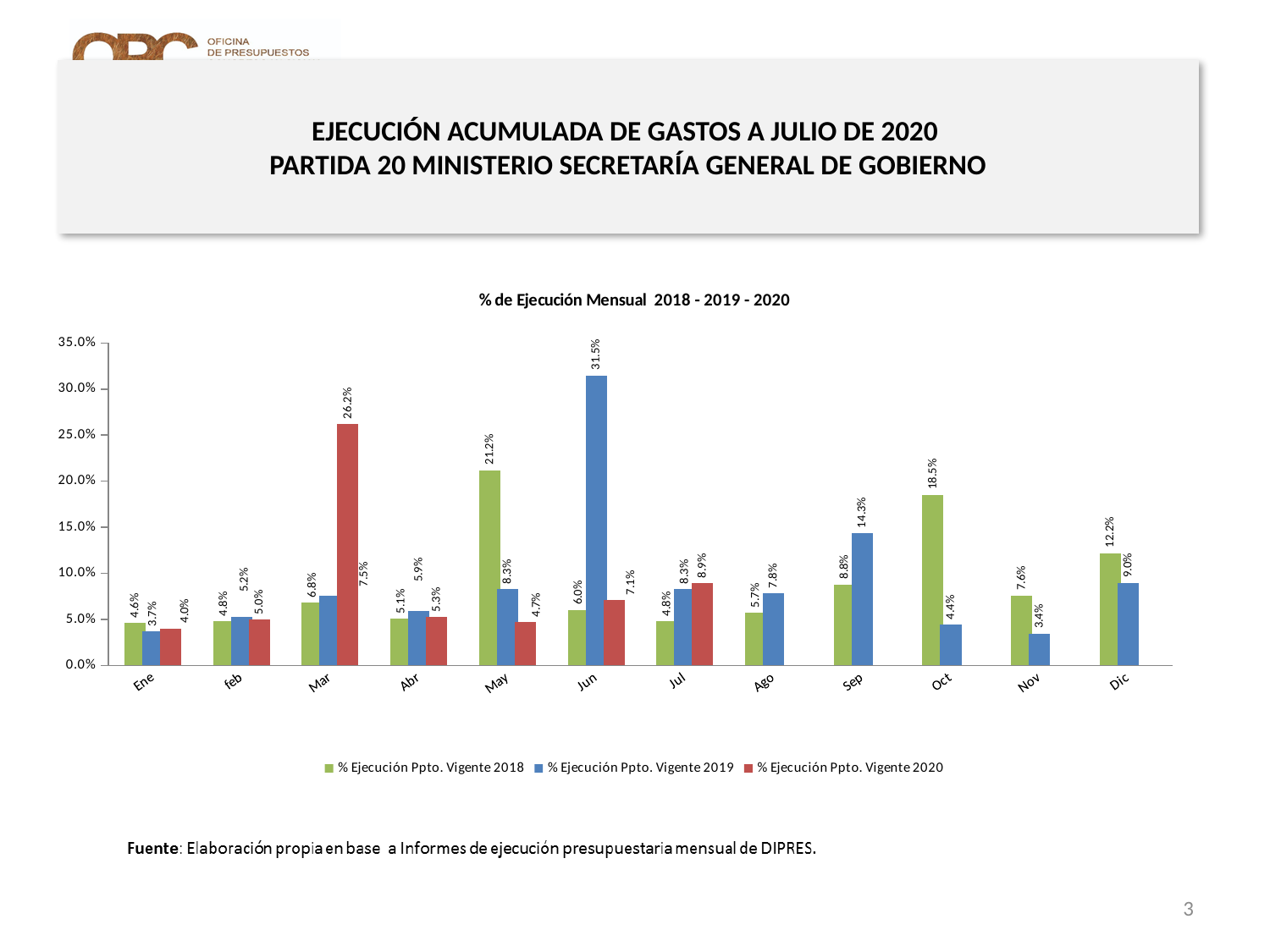
In which month is the % Ejecución Ppto. Vigente 2019 series lowest? Nov Which is larger in Jul: the 2019 value or the 2020 value? 2020 value (8.9%) In which month is the % Ejecución Ppto. Vigente 2018 series highest? May What is the value for % Ejecución Ppto. Vigente 2018 in Oct? 18.5% What is the difference between the 2019 and 2018 values in Sep? 5.5% Is the value for % Ejecución Ppto. Vigente 2019 in Jun greater or less than 30.0%? greater What kind of chart is shown on the slide? Bar chart What is the title of the chart? % de Ejecución Mensual 2018 - 2019 - 2020 What is the value for % Ejecución Ppto. Vigente 2019 in Jun? 31.5% What is the value for % Ejecución Ppto. Vigente 2020 in Mar? 26.2% How many series does the legend list? 3 How many months are shown on the x axis? 12